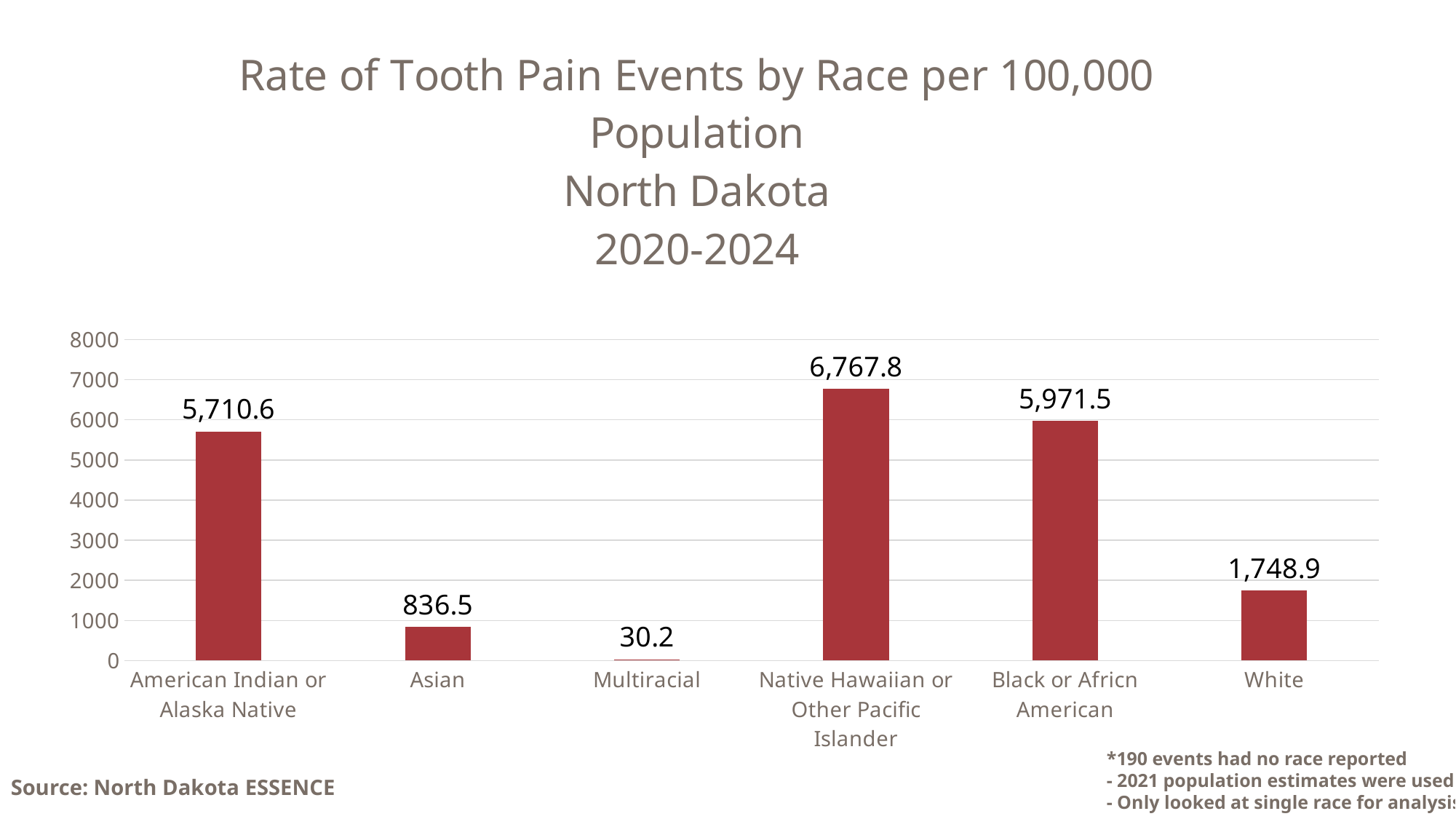
Which race category has the highest rate of tooth pain events? Native Hawaiian or Other Pacific Islander What is the rate of tooth pain events per 100,000 population for Multiracial? 30.2 What is the rate of tooth pain events per 100,000 population for American Indian or Alaska Native? 5,710.6 How many race categories are shown on the chart? 6 What kind of chart is shown on the slide? Bar chart What is the rate of tooth pain events per 100,000 population for White? 1,748.9 Which has a higher rate of tooth pain events, Black or African American or American Indian or Alaska Native? Black or African American Which race category has the lowest rate of tooth pain events? Multiracial What is the difference between the rates for Asian and White? 912.4 What is the source cited for the chart data? North Dakota ESSENCE What is the difference between the rates for Native Hawaiian or Other Pacific Islander and Black or African American? 796.3 Is the value for Asian greater or less than 1000? less